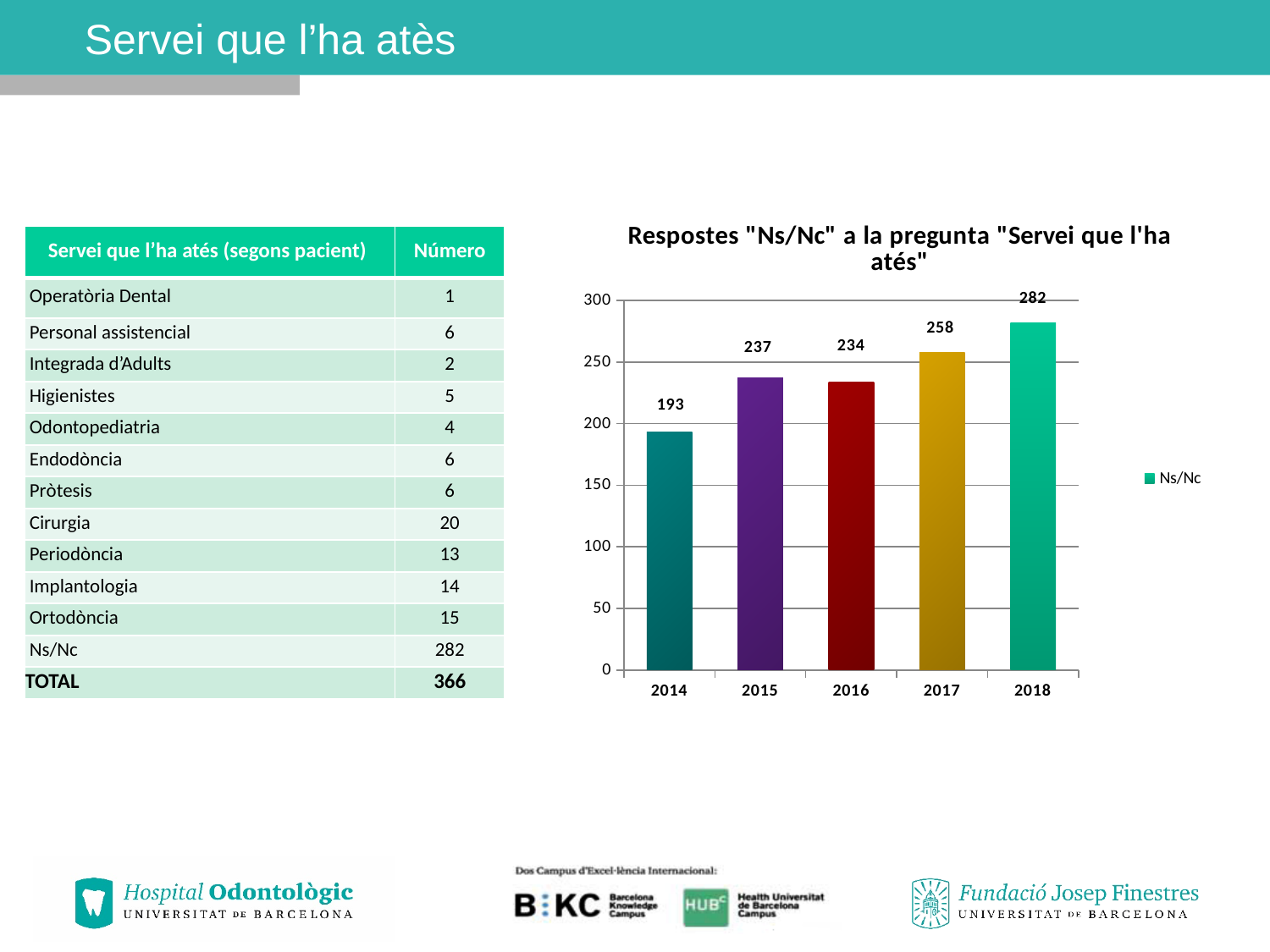
What kind of chart is shown on the slide? bar chart What is the difference between the values for 2018 and 2014? 89 Is the value for 2014 greater or less than 200? less What is the value for 2014 in the chart? 193 What is the value for 2016 in the chart? 234 Which year has the lowest value in the chart? 2014 What is the difference between the values for 2017 and 2016? 24 How many years are shown on the x axis of the chart? 5 Which is larger, the value for 2015 or the value for 2017? 2017 What is the value for 2017 in the chart? 258 Which year has the highest value in the chart? 2018 How many series does the chart legend list? 1